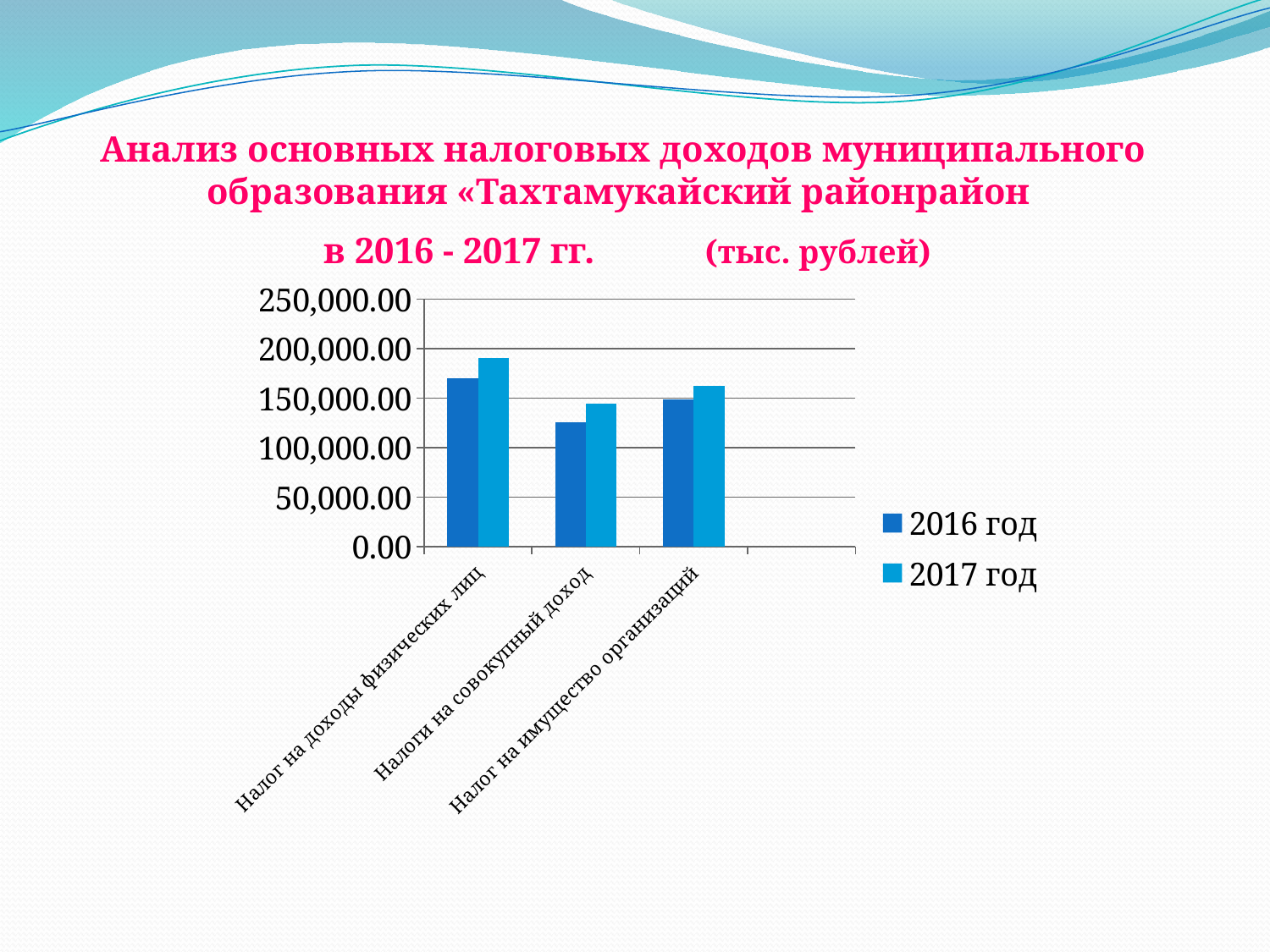
Is the value for Налог на доходы физических лиц in 2016 год greater or less than 150,000.00? greater Is the value for Налог на имущество организаций in 2017 год greater or less than 150,000.00? greater What kind of chart is shown on the slide? bar chart Is the value for Налоги на совокупный доход in 2016 год greater or less than 100,000.00? greater For Налог на имущество организаций, which year has the larger value, 2016 год or 2017 год? 2017 год How many categories are shown on the x axis of the chart? 3 Which category has the highest value for 2017 год? Налог на доходы физических лиц For Налоги на совокупный доход, which year has the larger value, 2016 год or 2017 год? 2017 год Which category has the lowest value for 2016 год? Налоги на совокупный доход What are the two series listed in the chart's legend? 2016 год and 2017 год How many series does the chart's legend list? 2